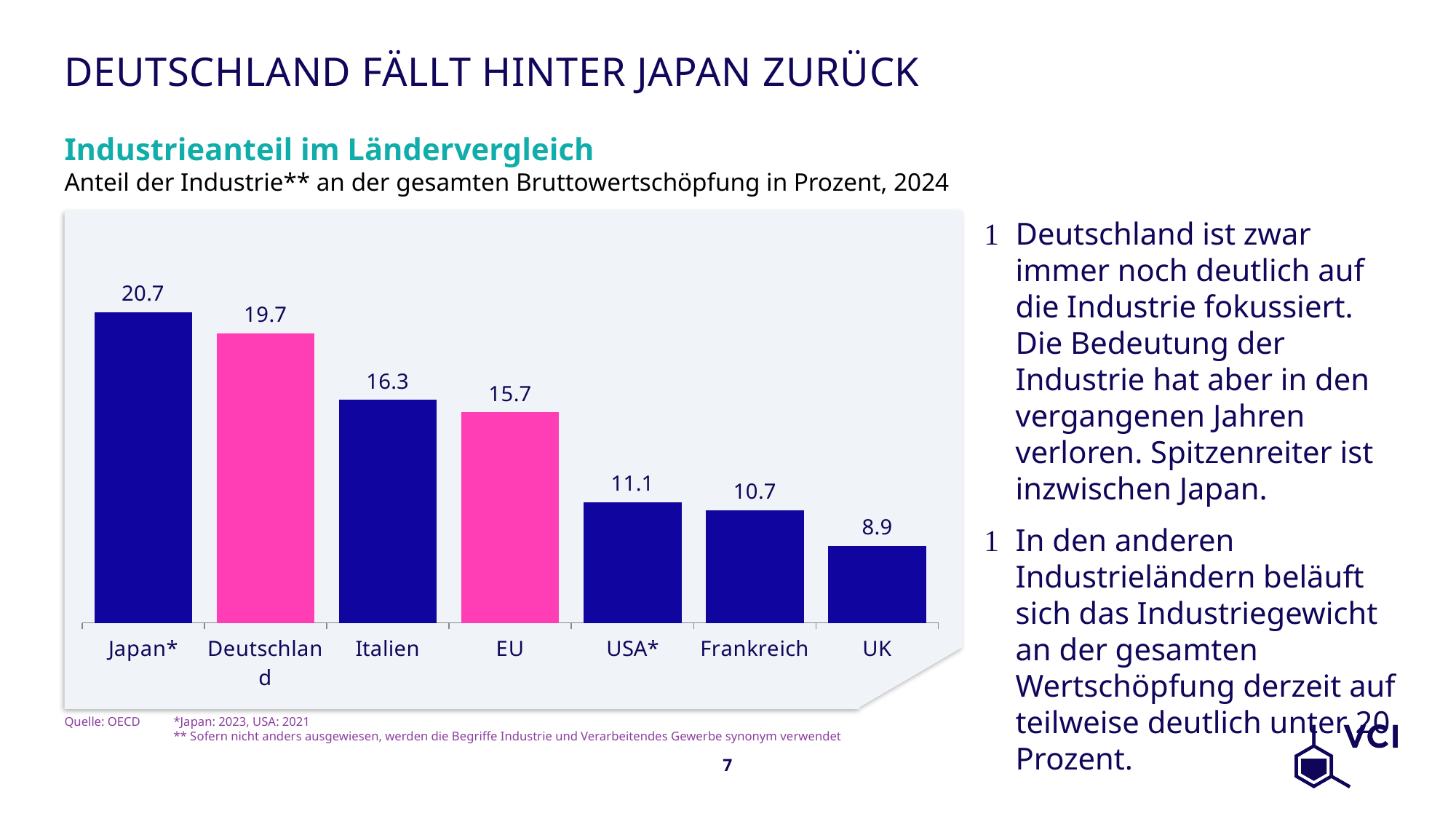
Which category has the highest value? Japan* What is the value for Japan*? 20.7 Do the values rise or fall from left to right along the x axis? Fall Which is larger, the value for USA* or the value for Frankreich? USA* What is the difference between the values for Italien and EU? 0.6 What kind of chart is shown on the slide? Bar chart What is the difference between the values for Japan* and Deutschland? 1.0 How many categories are shown in the chart? 7 What is the value for Deutschland? 19.7 Which category has the lowest value? UK What is the value for Frankreich? 10.7 Which two categories are shown with pink bars? Deutschland and EU